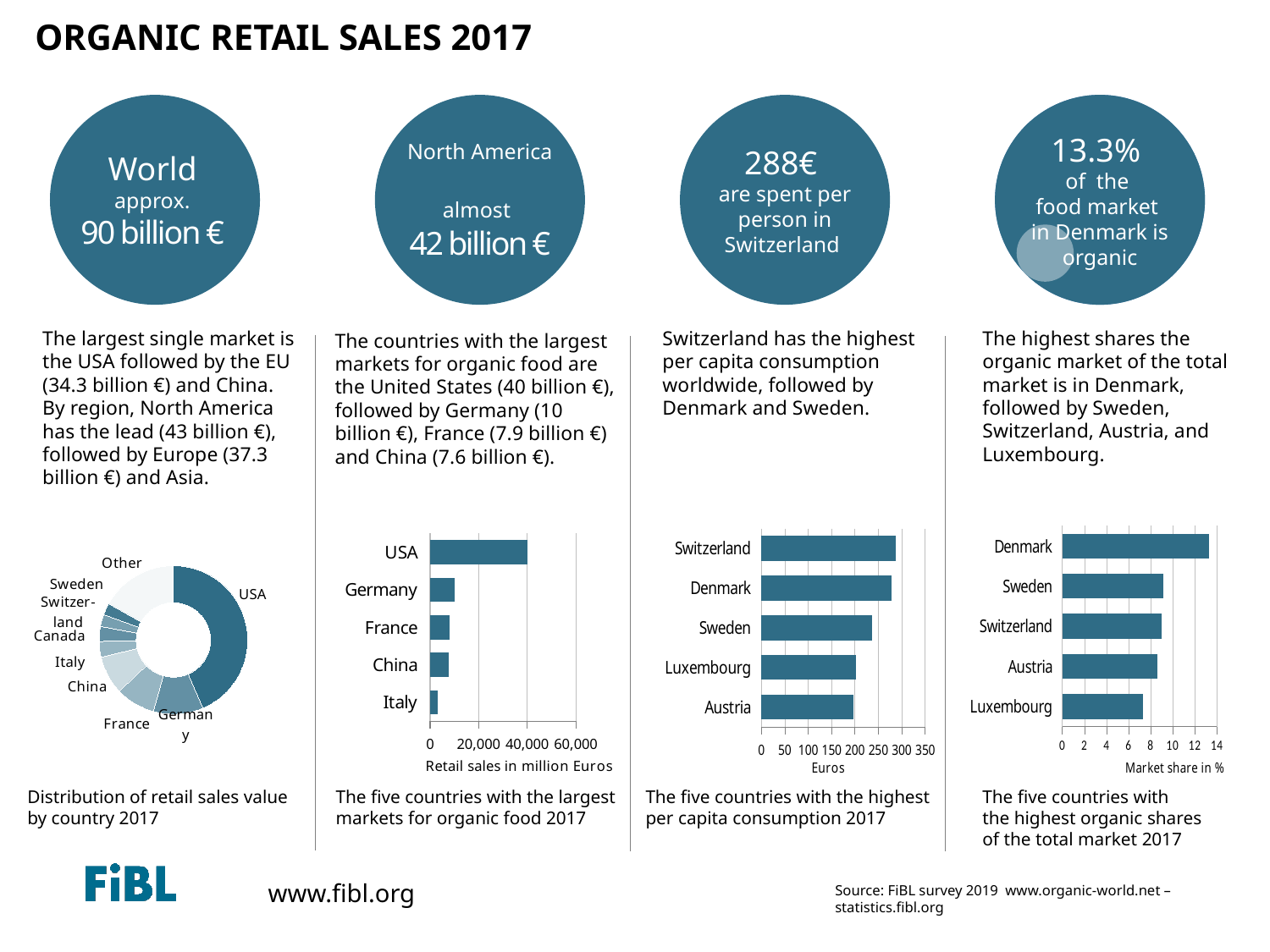
In the chart 'The five countries with the highest per capita consumption 2017', which has a higher value, Denmark or Sweden? Denmark In the chart 'The five countries with the highest organic shares of the total market 2017', is the value for Denmark greater or less than 12? greater In the chart 'The five countries with the largest markets for organic food 2017', is the value for Germany greater or less than 20,000? less How many countries are shown in the chart 'The five countries with the highest organic shares of the total market 2017'? 5 In the chart 'The five countries with the largest markets for organic food 2017', which has larger retail sales, Germany or France? Germany In the chart 'The five countries with the largest markets for organic food 2017', which country has the highest retail sales? USA In the chart 'The five countries with the highest per capita consumption 2017', which country has the highest per capita consumption? Switzerland In the chart 'The five countries with the highest per capita consumption 2017', is the value for Austria greater or less than 250? less What type of chart is 'Distribution of retail sales value by country 2017'? Pie (donut) chart In the chart 'The five countries with the largest markets for organic food 2017', which country has the lowest retail sales? Italy In the chart 'The five countries with the highest organic shares of the total market 2017', which country has the lowest market share? Luxembourg